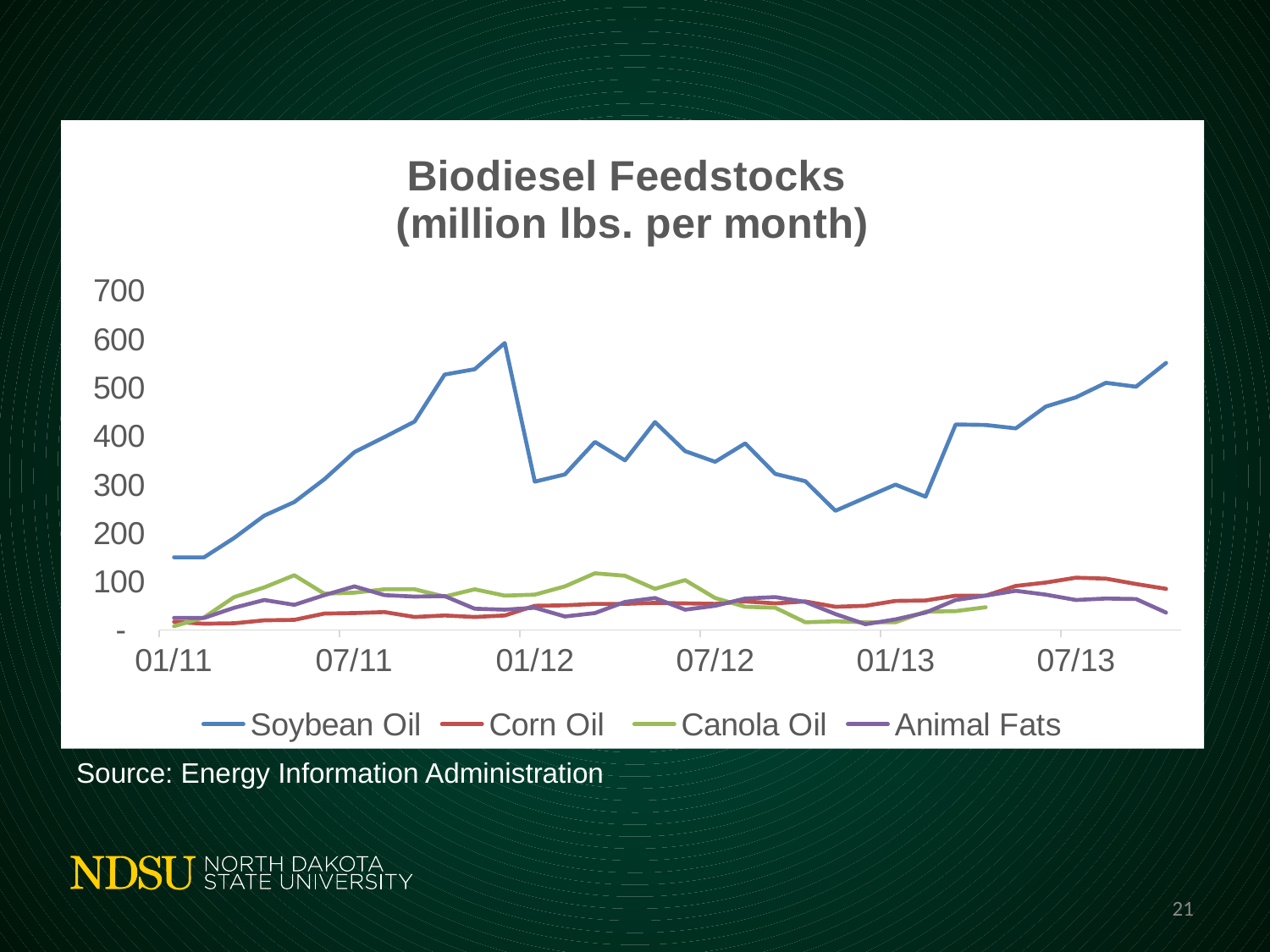
How many series does the legend list? 4 Is the Soybean Oil value larger at 01/11 or at 07/13? 07/13 Is the value for Soybean Oil at 07/13 greater or less than 400? greater Does the Soybean Oil line rise or fall between 01/11 and 07/11? rise What is the title of the chart? Biodiesel Feedstocks (million lbs. per month) Is the value for Soybean Oil at 01/11 greater or less than 100? greater Is the value for Soybean Oil at 07/11 greater or less than 300? greater Which series has the highest values across the whole period? Soybean Oil What kind of chart is shown on the slide? line chart How many date labels are shown on the x axis? 6 Which is larger at 07/12, Soybean Oil or Corn Oil? Soybean Oil